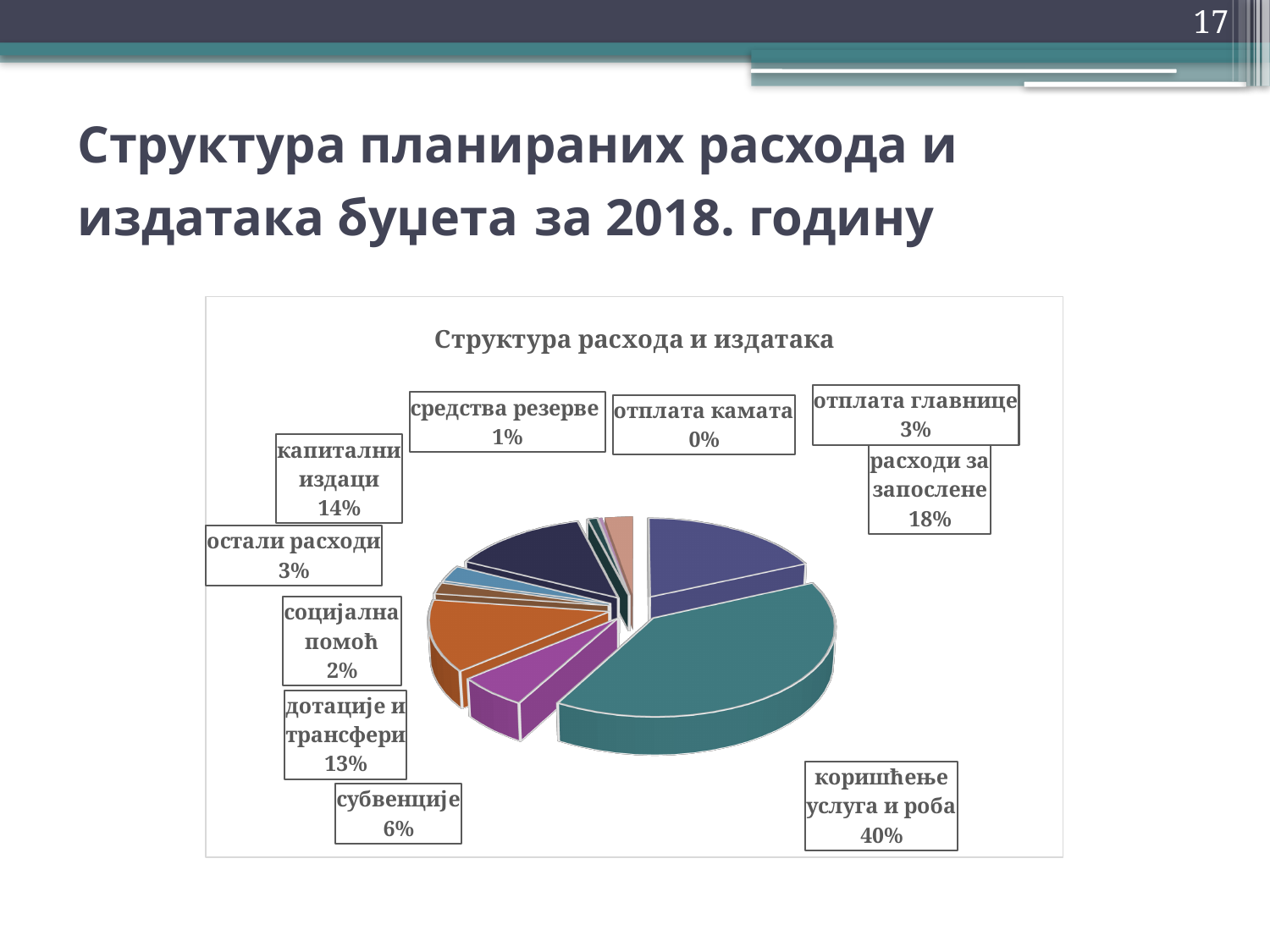
Which category has the smallest share of the pie? отплата камата What share of the pie is капитални издаци? 14% What is the difference in percentage points between коришћење услуга и роба and расходи за запослене? 22 What share of the pie is субвенције? 6% What share of the pie is дотације и трансфери? 13% How many categories are shown in the pie chart? 10 Which is larger, the share for капитални издаци or the share for дотације и трансфери? капитални издаци What is the title of the chart? Структура расхода и издатака Which category has the largest share of the pie? коришћење услуга и роба What type of chart is shown on the slide? pie chart